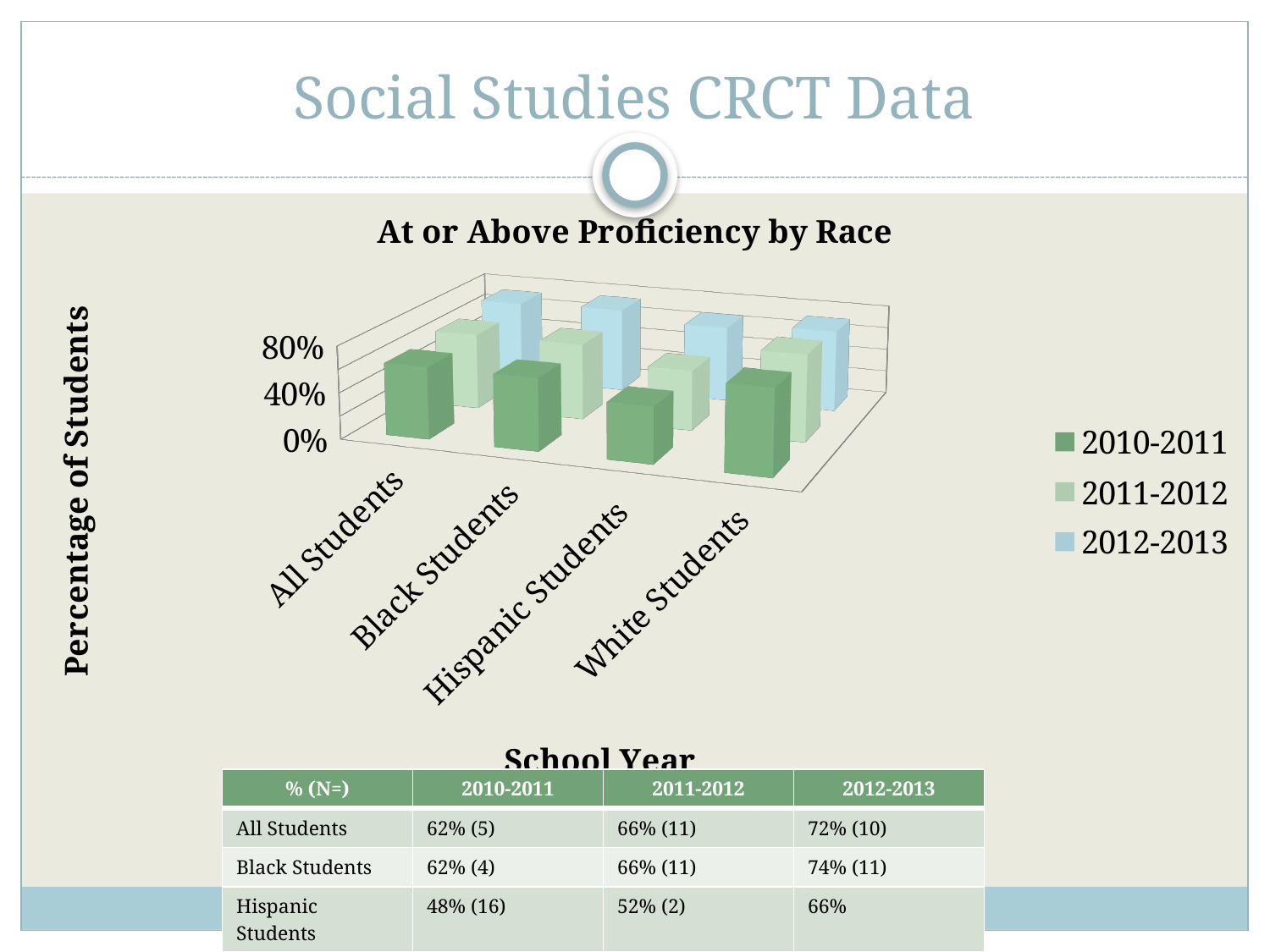
Do the values for All Students rise or fall from 2010-2011 to 2012-2013? rise Is the value for White Students in 2012-2013 greater or less than 40%? greater How many series does the chart legend list? 3 What percentage of Black Students were at or above proficiency in 2012-2013? 74% What is the label on the vertical axis of the chart? Percentage of Students What is the title of the chart? At or Above Proficiency by Race By how many percentage points did the All Students value increase from 2010-2011 to 2012-2013? 10% What percentage of All Students were at or above proficiency in 2010-2011? 62% How many student categories are shown on the x axis of the chart? 4 What kind of chart is shown on the slide? bar chart In 2010-2011, which had the higher value: Black Students or Hispanic Students? Black Students What percentage of Hispanic Students were at or above proficiency in 2012-2013? 66%